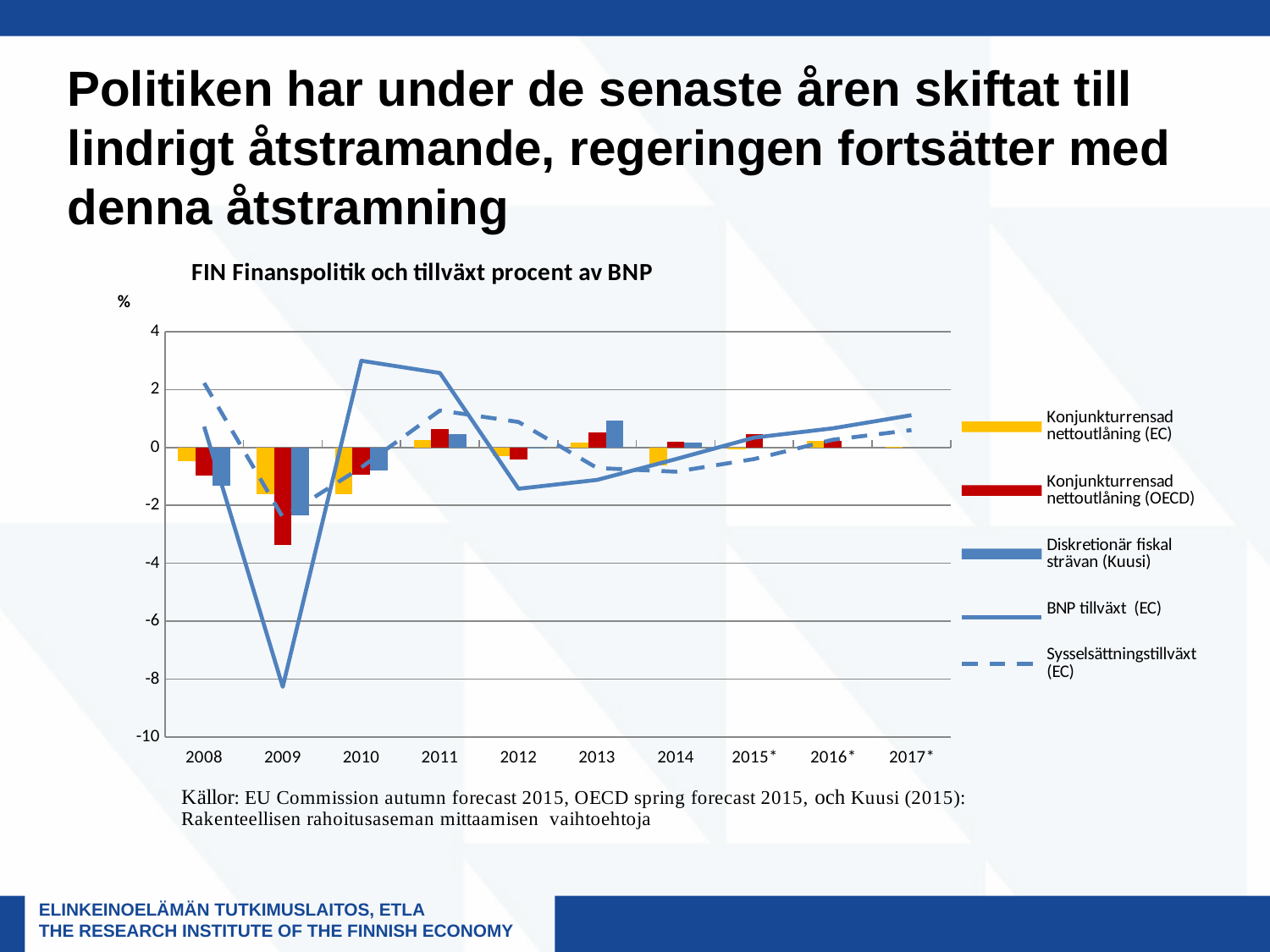
Is the value of Konjunkturrensad nettoutlåning (OECD) in 2009 greater or less than -2? less Is the value of BNP tillväxt (EC) in 2010 greater or less than 2? greater How many series does the legend list? 5 In 2009, which is lower: Konjunkturrensad nettoutlåning (EC) or Konjunkturrensad nettoutlåning (OECD)? Konjunkturrensad nettoutlåning (OECD) Which colour represents Konjunkturrensad nettoutlåning (EC) in the legend? Yellow What is the title of the chart? FIN Finanspolitik och tillväxt procent av BNP In which year does the BNP tillväxt (EC) line reach its lowest value? 2009 Is the value of BNP tillväxt (EC) in 2009 greater or less than -6? less What kind of chart is shown on the slide? A combined bar and line chart In which year is the Konjunkturrensad nettoutlåning (OECD) bar lowest? 2009 How many years are shown on the x axis? 10 Does the BNP tillväxt (EC) line rise or fall from 2012 to 2017*? rise